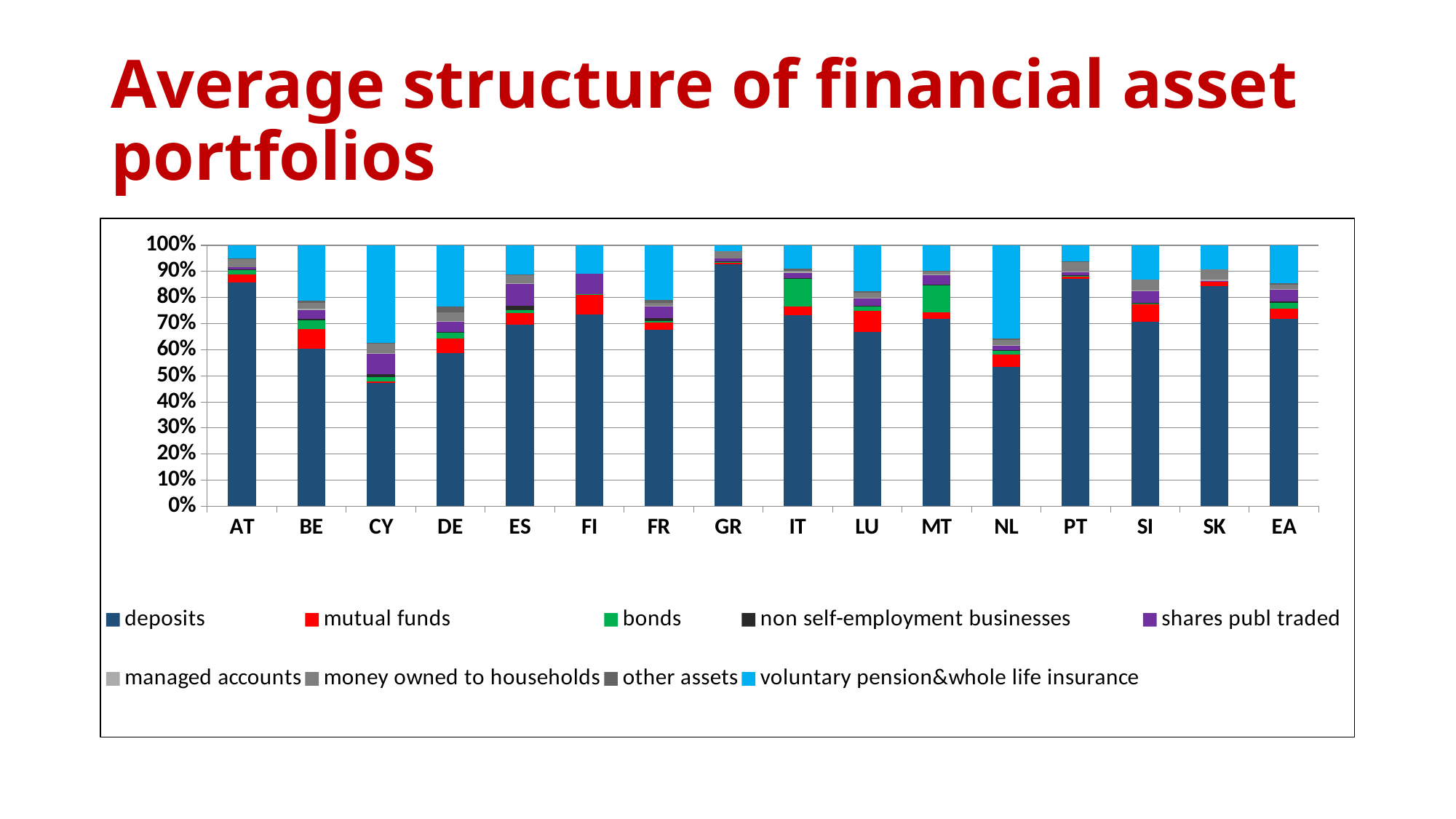
Is the deposits share for AT greater or less than 80%? greater Which has a larger share of deposits, AT or BE? AT How many series does the chart's legend list? 9 What is the total of the stacked bar for AT? 100% What is the title of the slide containing the chart? Average structure of financial asset portfolios Which category has the smallest share of deposits? CY Which series is shown in light blue at the top of each bar? voluntary pension&whole life insurance What kind of chart is shown on the slide? Stacked bar chart Is the deposits share for GR greater or less than 90%? greater How many countries/categories are shown on the x axis of the chart? 16 Is the deposits share for CY greater or less than 50%? less Which category has the largest share of deposits? GR